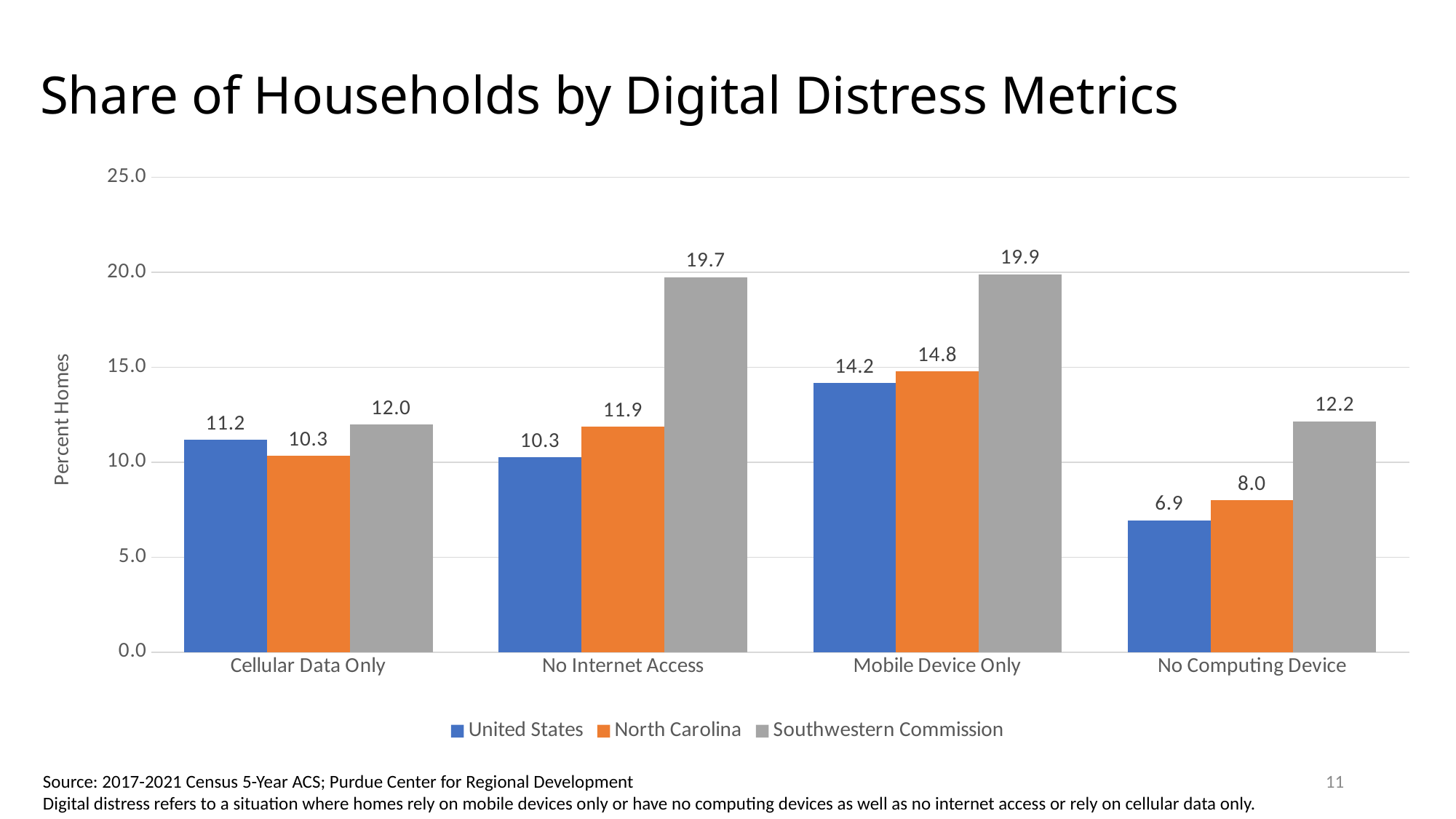
Is the value for Southwestern Commission in the No Computing Device category greater or less than 10.0? greater What is the value for United States in the No Computing Device category? 6.9 What is the value for Southwestern Commission in the No Internet Access category? 19.7 Which category has the highest value for Southwestern Commission? Mobile Device Only Which is larger in the Cellular Data Only category: United States or North Carolina? United States How many categories are shown on the x axis? 4 What is the label of the y axis? Percent Homes Which category has the lowest value for North Carolina? No Computing Device What is the value for North Carolina in the Mobile Device Only category? 14.8 How many series does the legend list? 3 What kind of chart is shown on the slide? bar chart What is the difference between the Southwestern Commission and United States values in the No Internet Access category? 9.4